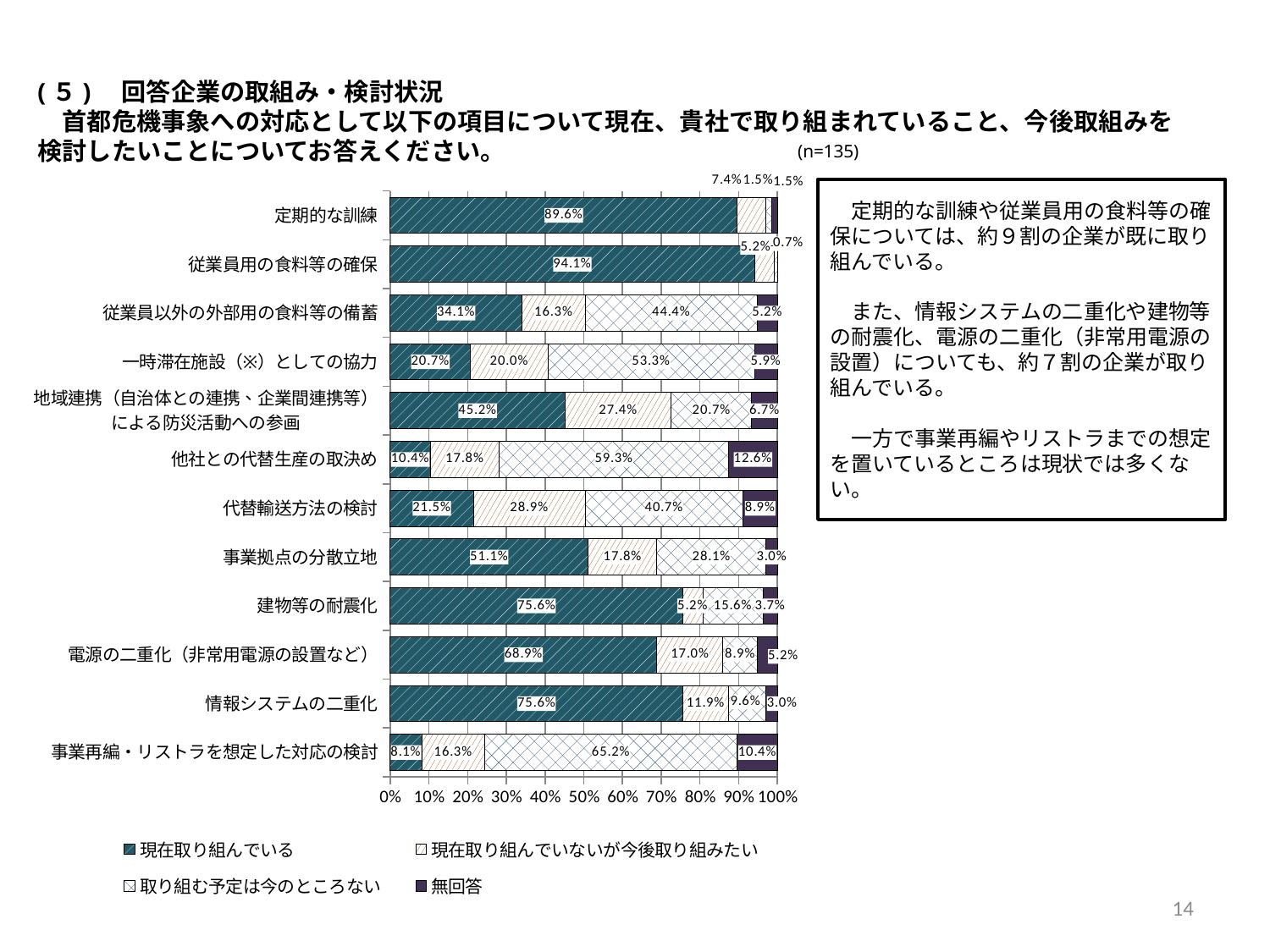
What is the value of 現在取り組んでいる for 従業員用の食料等の確保? 94.1% What is the value of 取り組む予定は今のところない for 事業再編・リストラを想定した対応の検討? 65.2% What is the value of 無回答 for 他社との代替生産の取決め? 12.6% What sample size (n) is shown on the slide for the chart? n=135 What is the difference between the 現在取り組んでいる values for 定期的な訓練 and 事業拠点の分散立地? 38.5% How many series does the legend list? 4 Which category has the lowest value for 現在取り組んでいる? 事業再編・リストラを想定した対応の検討 Which has a larger 現在取り組んでいる value: 電源の二重化（非常用電源の設置など） or 地域連携（自治体との連携、企業間連携等）による防災活動への参画? 電源の二重化（非常用電源の設置など） How many categories (items) are plotted on the chart? 12 What kind of chart is shown on the slide? Stacked bar chart What is the value of 現在取り組んでいないが今後取り組みたい for 代替輸送方法の検討? 28.9% Which category has the highest value for 現在取り組んでいる? 従業員用の食料等の確保